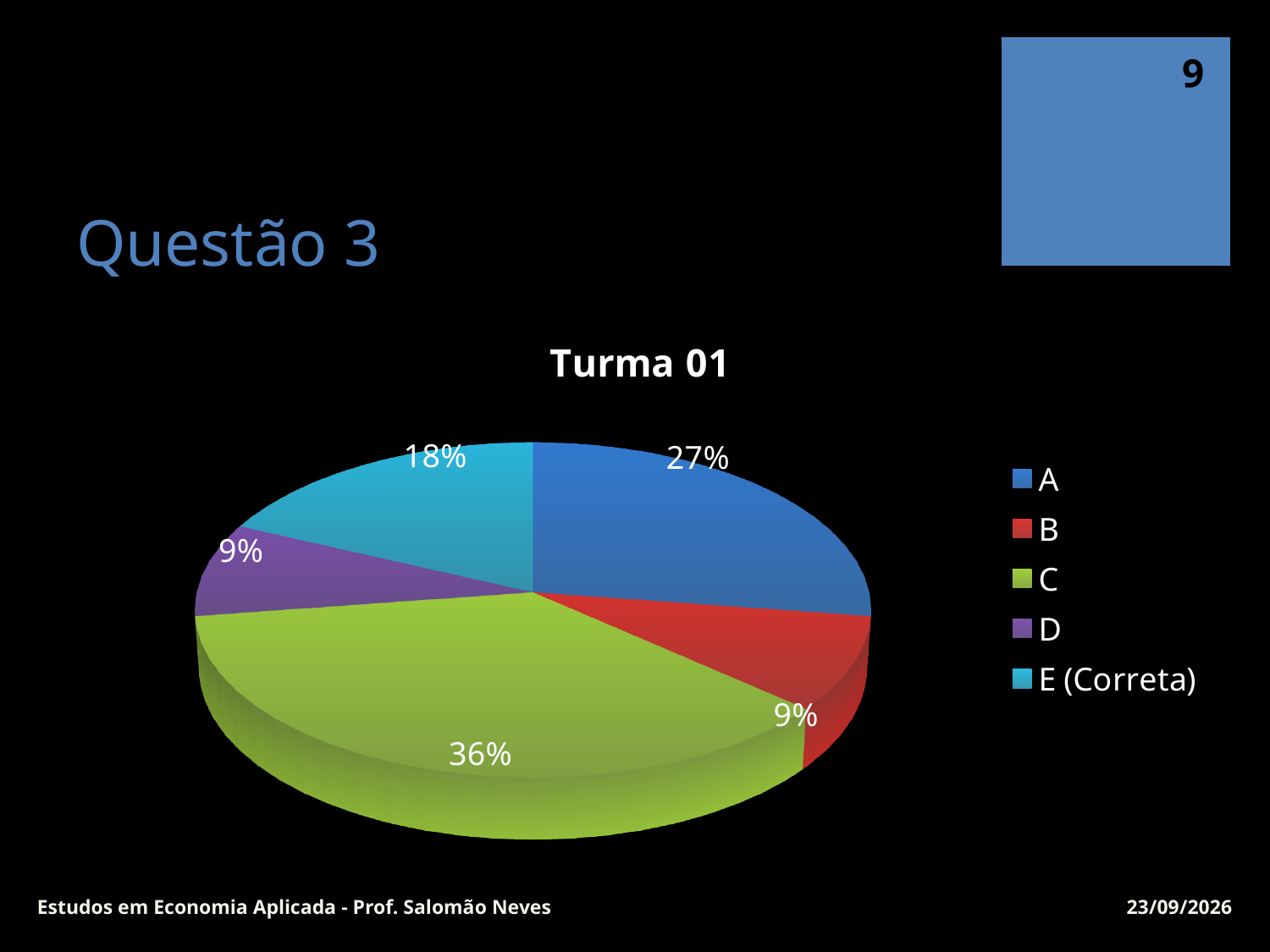
What percentage of the pie does slice C represent? 36% What is the title of the chart? Turma 01 What percentage of the pie does slice A represent? 27% How many slices does the pie chart have? 5 What percentage of the pie does slice B represent? 9% Which slice is larger, A or E (Correta)? A What is the difference in percentage points between slice C and slice A? 9 What type of chart is shown on the slide? Pie chart Which legend entry is marked as the correct answer? E (Correta) Which category has the largest slice of the pie? C How many entries does the legend list? 5